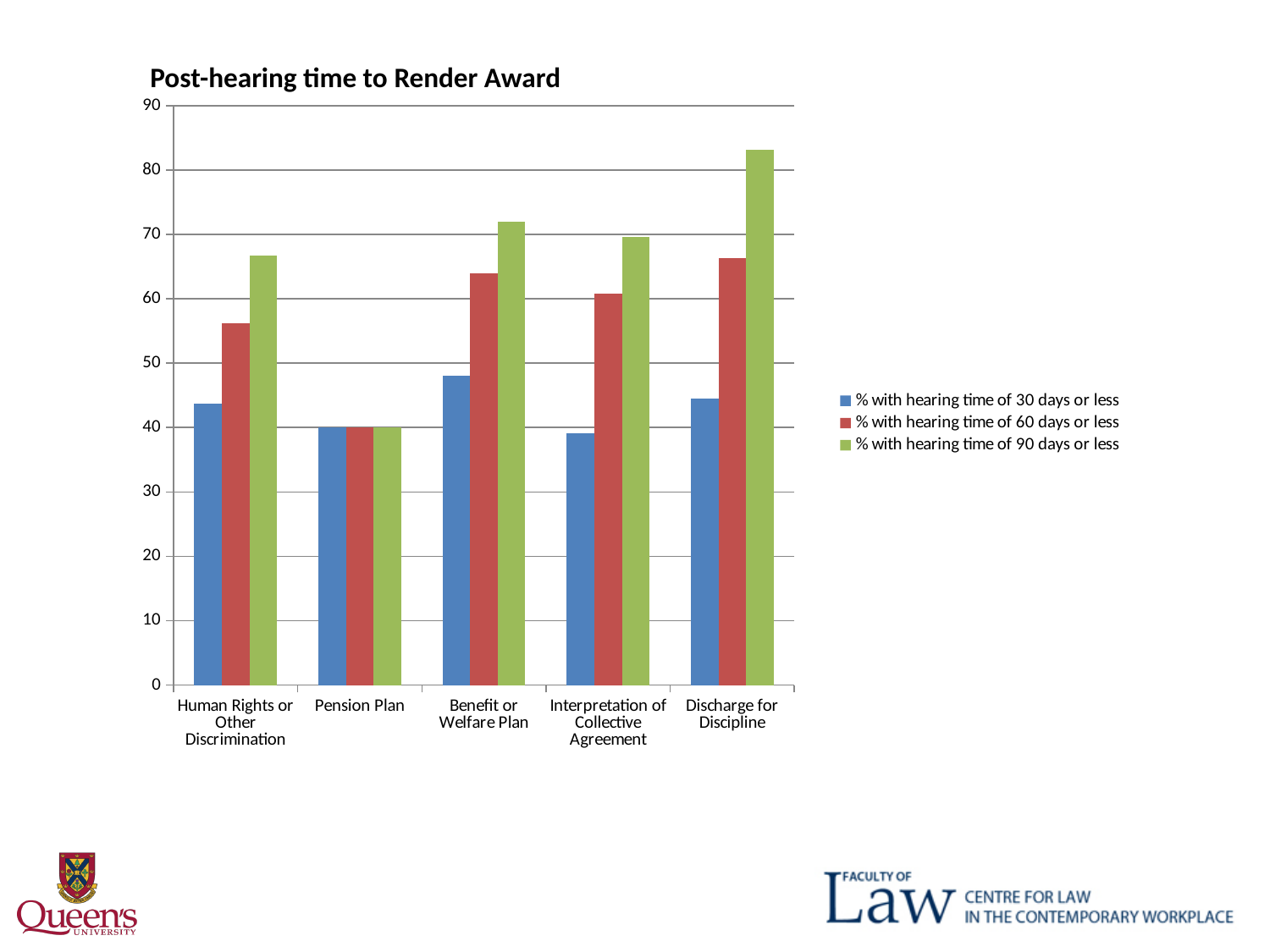
How many series does the legend list? 3 Which category has the lowest value for '% with hearing time of 30 days or less'? Interpretation of Collective Agreement Is the value for '% with hearing time of 90 days or less' for Discharge for Discipline greater or less than 80? greater What kind of chart is shown on the slide? bar chart Which category has the highest value for '% with hearing time of 30 days or less'? Benefit or Welfare Plan Is the value for '% with hearing time of 30 days or less' for Benefit or Welfare Plan greater or less than 50? less Which category has the lowest value for '% with hearing time of 90 days or less'? Pension Plan What is the title of the chart? Post-hearing time to Render Award Which is larger for Benefit or Welfare Plan: '% with hearing time of 60 days or less' or '% with hearing time of 90 days or less'? % with hearing time of 90 days or less Which category has the highest value for '% with hearing time of 90 days or less'? Discharge for Discipline Is the value for '% with hearing time of 60 days or less' for Human Rights or Other Discrimination greater or less than 50? greater How many categories are shown on the x axis? 5